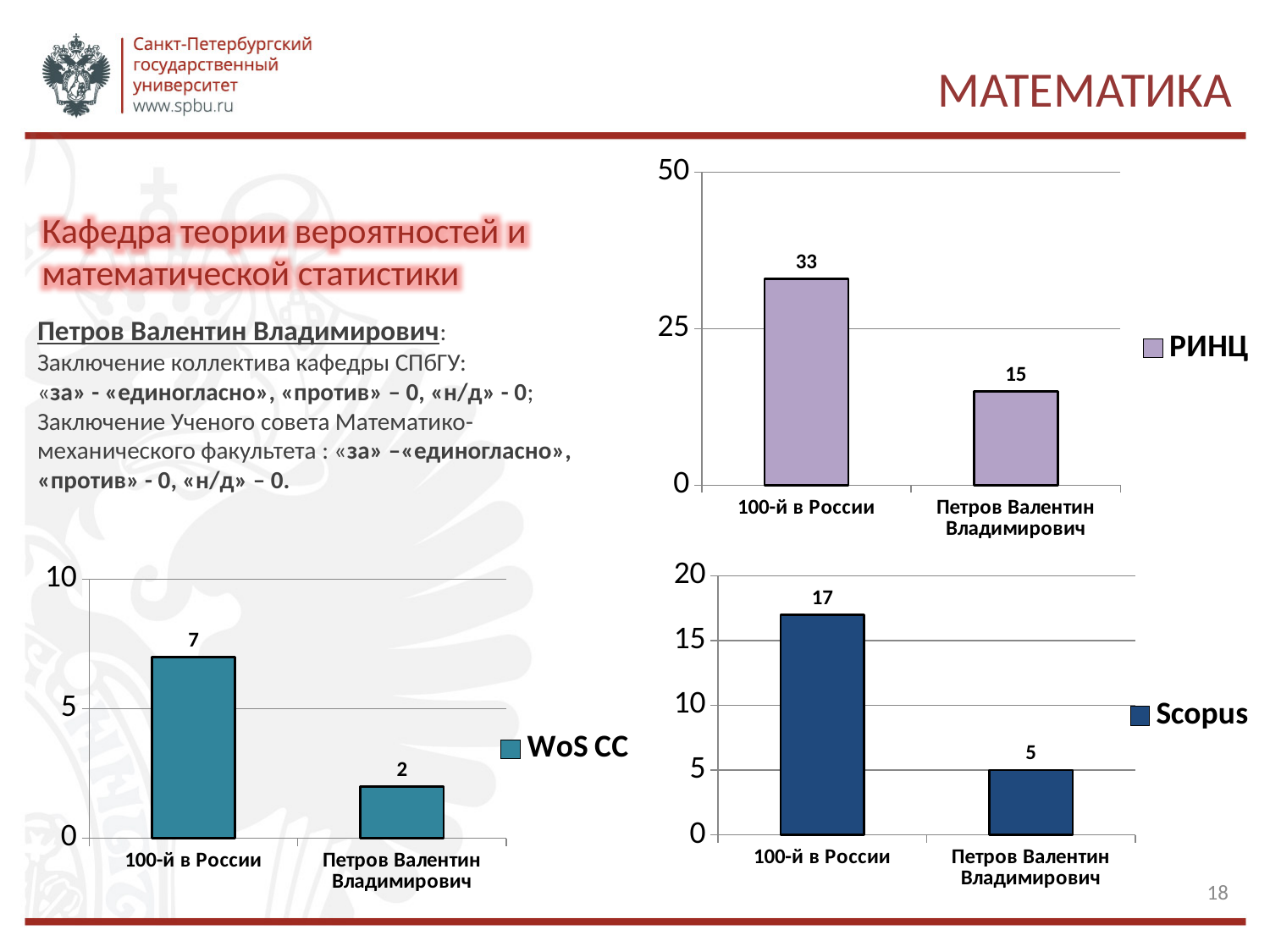
In the РИНЦ chart (top right), what is the value for 100-й в России? 33 In the Scopus chart (bottom right), which category has the highest value? 100-й в России In the WoS CC chart (bottom left), what is the value for 100-й в России? 7 In the РИНЦ chart (top right), what is the difference between the values for 100-й в России and Петров Валентин Владимирович? 18 In the WoS CC chart (bottom left), which category has the lowest value? Петров Валентин Владимирович In the Scopus chart (bottom right), what is the value for Петров Валентин Владимирович? 5 In the Scopus chart (bottom right), what is the difference between the values for 100-й в России and Петров Валентин Владимирович? 12 In the Scopus chart (bottom right), what is the value for 100-й в России? 17 In the WoS CC chart (bottom left), what is the value for Петров Валентин Владимирович? 2 In the РИНЦ chart (top right), what is the value for Петров Валентин Владимирович? 15 How many categories are shown in the РИНЦ chart (top right)? 2 What kind of chart is the WoS CC chart (bottom left)? Bar chart